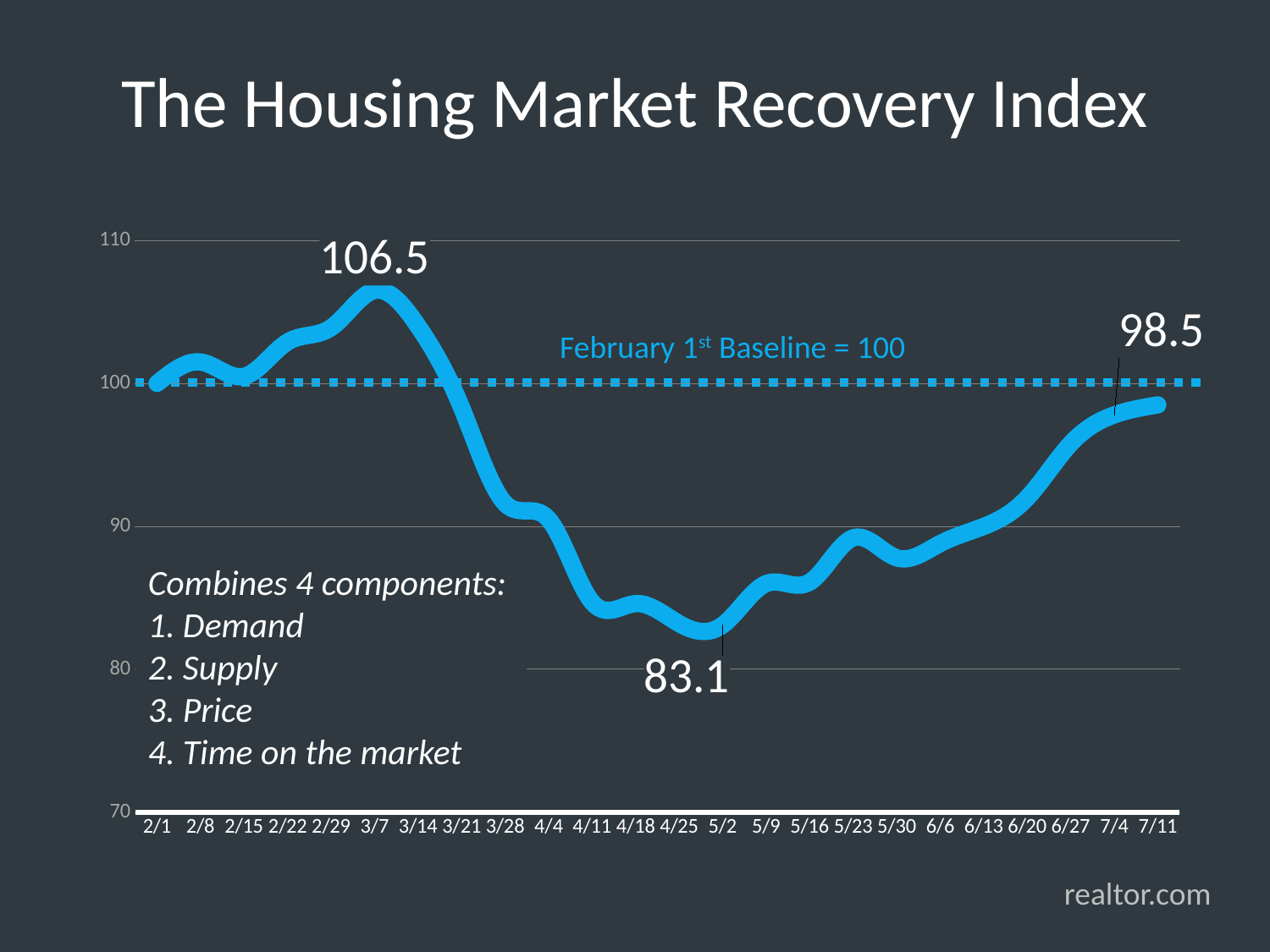
What is the lowest value labeled on the chart? 83.1 Is the value for 2/22 greater or less than 100? greater What is the value of the Housing Market Recovery Index on 5/2? 83.1 What is the highest value labeled on the chart? 106.5 What is the difference between the peak value of 106.5 and the low of 83.1? 23.4 Is the value for 4/11 greater or less than 90? less Does the index rise or fall between 5/2 and 7/11? rise How many dates are labeled along the x axis? 24 What value does the dashed February 1st baseline represent? 100 What is the value of the Housing Market Recovery Index on 3/7? 106.5 What kind of chart is shown on the slide? line chart How much higher is the peak value of 106.5 than the final labeled value of 98.5? 8